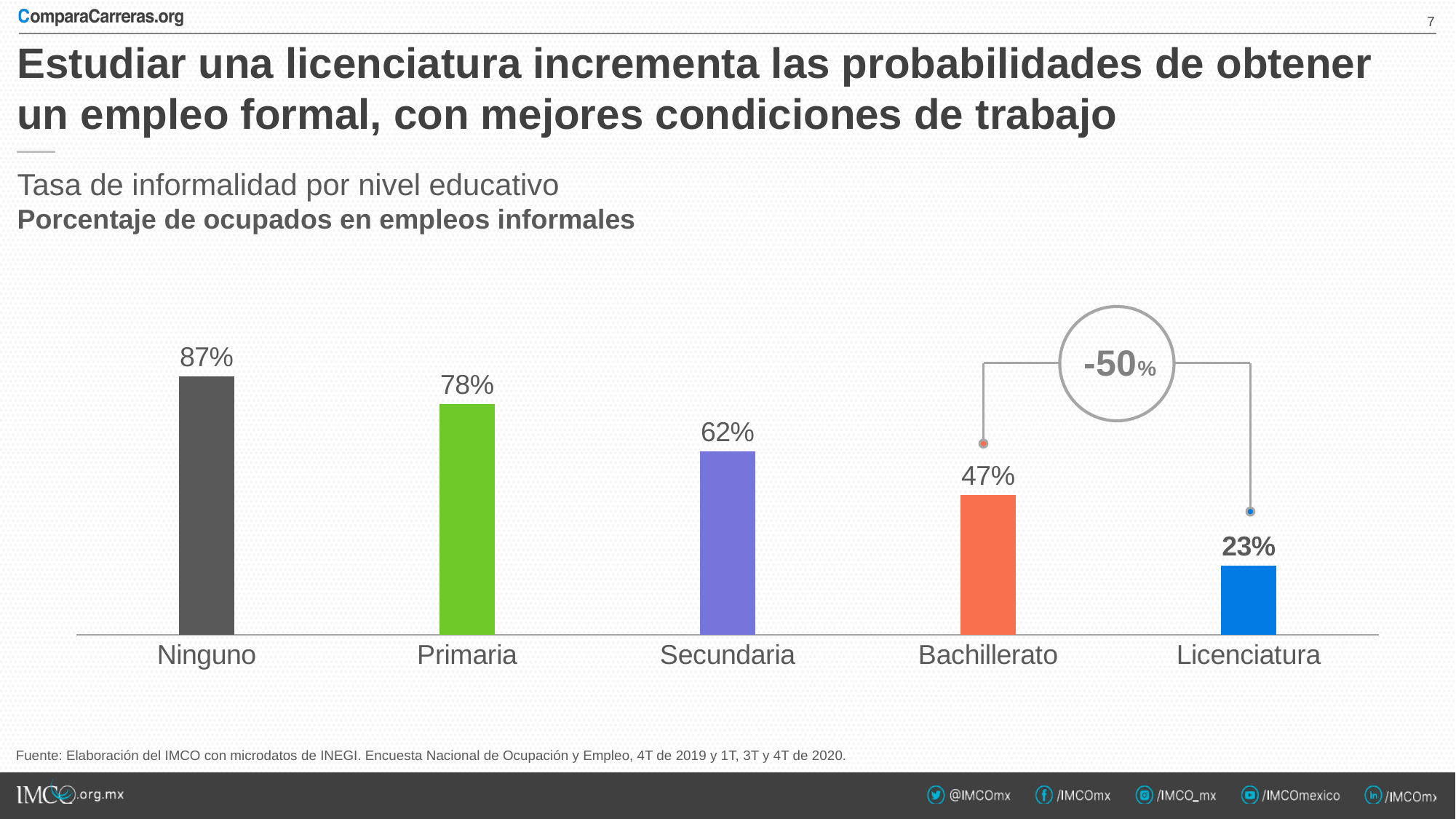
What percentage change is shown in the circle between Bachillerato and Licenciatura? -50% What is the informality rate for Ninguno? 87% Which has a higher informality rate, Secundaria or Bachillerato? Secundaria How many education levels are shown in the chart? 5 What is the difference in informality rate between Primaria and Bachillerato? 31 percentage points What kind of chart is shown on the slide? Bar chart Which education level has the lowest informality rate? Licenciatura What is the informality rate for Licenciatura? 23% Which education level has the highest informality rate? Ninguno What is the difference in informality rate between Bachillerato and Licenciatura? 24 percentage points Do the informality rates rise or fall from Ninguno to Licenciatura? Fall What is the informality rate for Secundaria? 62%